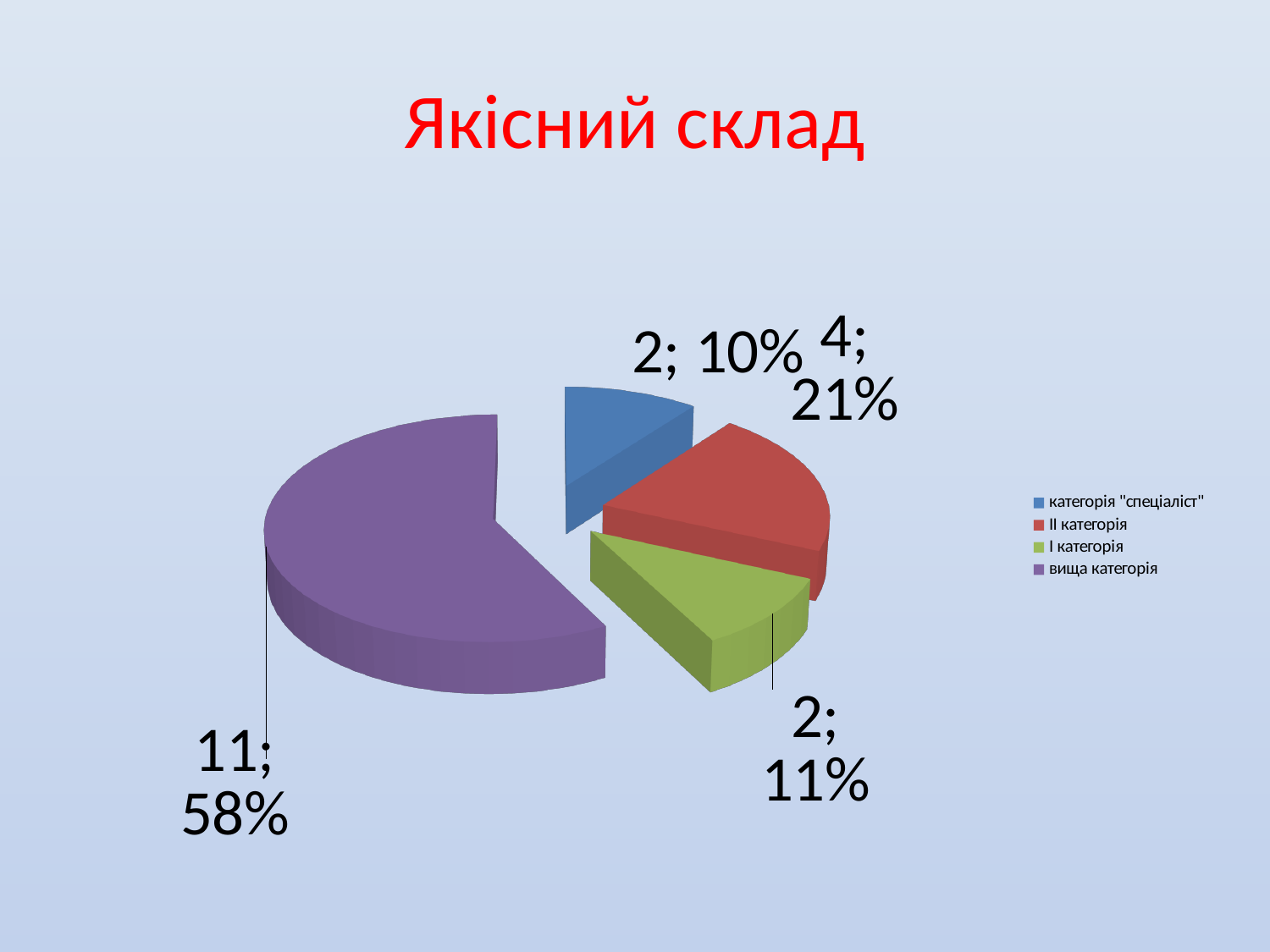
Which category has the largest slice? вища категорія How many categories does the legend list? 4 Which colour represents вища категорія in the chart? purple What share of the pie does ІІ категорія take? 21% What share of the pie does І категорія take? 11% What value is shown for вища категорія? 11 What is the title of the chart? Якісний склад What is the difference in value between вища категорія and ІІ категорія? 7 What kind of chart is shown on the slide? pie chart What share of the pie does вища категорія take? 58% What value is shown for ІІ категорія? 4